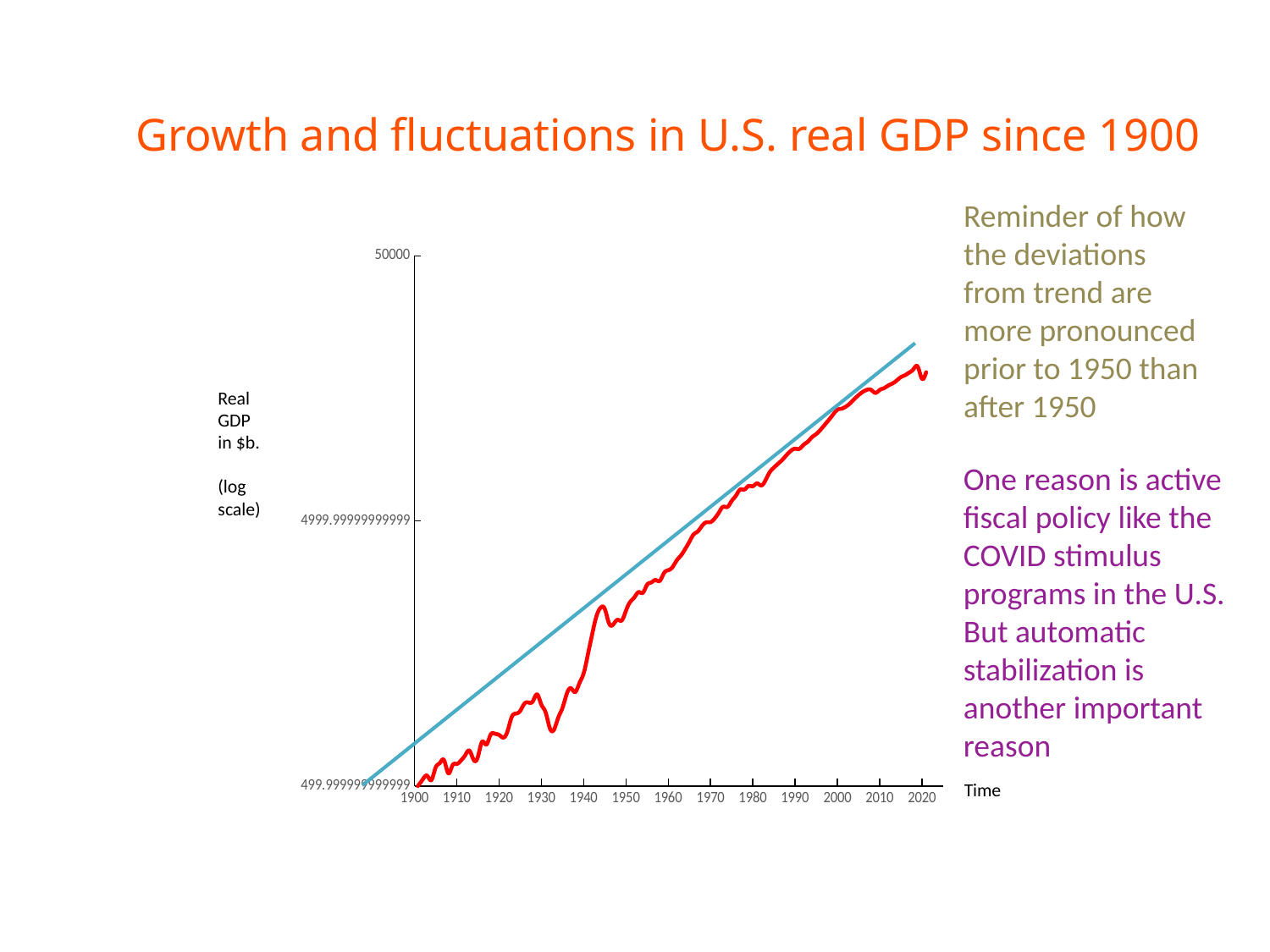
Is the red real GDP value for 1980 greater or less than 4999.99999999999? greater What kind of chart is shown on the slide? Line chart Is the red real GDP value higher in 1950 or in 1940? 1950 What is the first year shown on the horizontal axis? 1900 Is the red real GDP value for 1940 greater or less than 4999.99999999999? less What is the title of the chart on the slide? Growth and fluctuations in U.S. real GDP since 1900 Does the red real GDP line generally rise or fall from 1900 to 2020? Rise How many year labels are shown on the horizontal axis? 13 How many lines are plotted on the chart? 2 Is the red real GDP value higher in 1900 or in 2020? 2020 What is the label on the vertical axis of the chart? Real GDP in $b. (log scale) Is the red real GDP value for 2020 greater or less than 50000? less